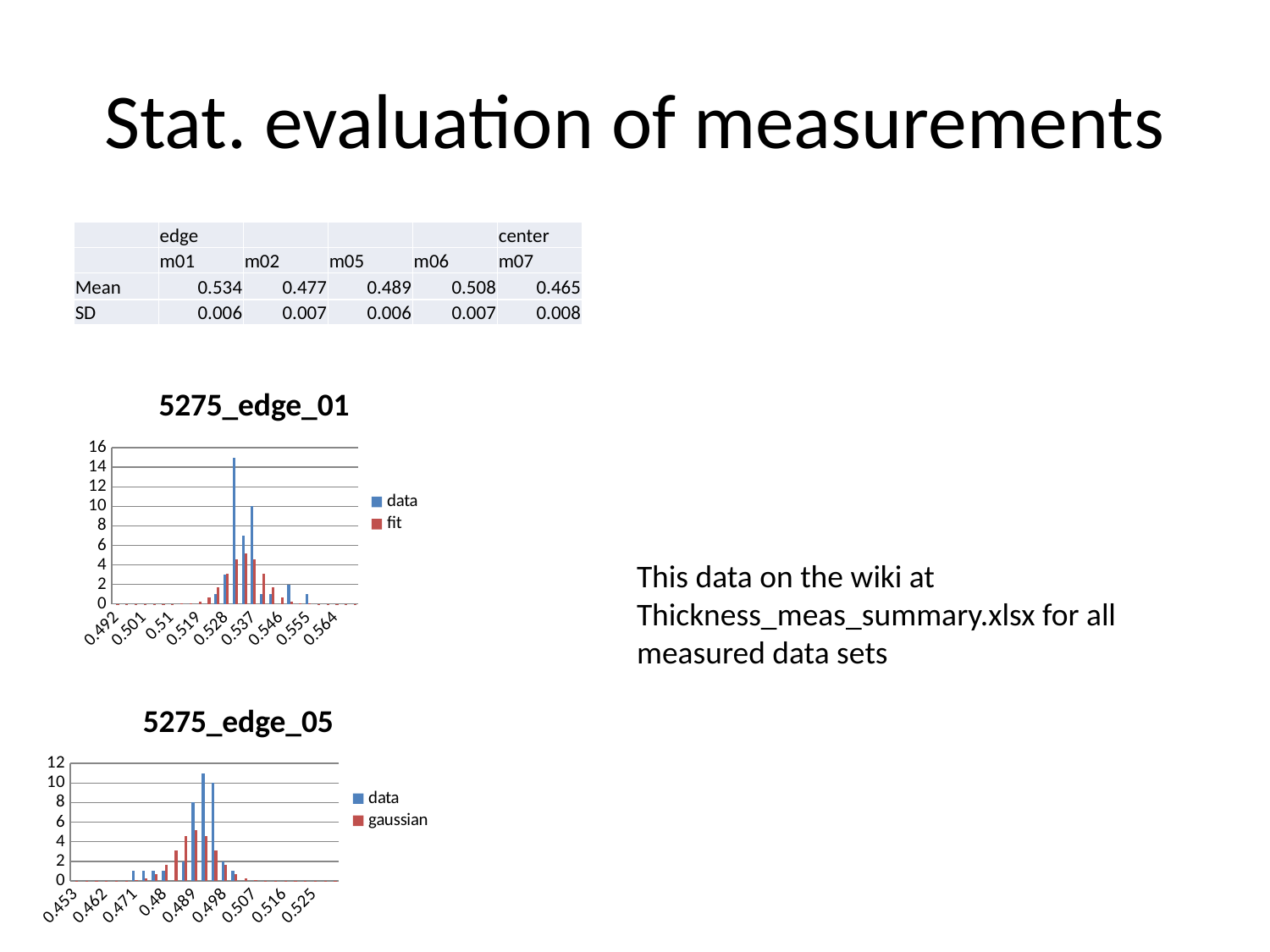
What are the two legend entries of the 5275_edge_01 chart? data and fit How many series does the legend of the 5275_edge_01 chart list? 2 What are the two legend entries of the 5275_edge_05 chart? data and gaussian In the 5275_edge_01 chart, which series has the taller peak bar, data or fit? data How many x-axis tick labels are shown on the 5275_edge_05 chart? 9 How many series does the legend of the 5275_edge_05 chart list? 2 What kind of chart is the 5275_edge_01 chart? bar chart What is the highest value shown on the y axis of the 5275_edge_01 chart? 16 What kind of chart is the 5275_edge_05 chart? bar chart In the 5275_edge_05 chart, is the tallest data bar greater or less than 8? greater In the 5275_edge_01 chart, is the tallest data bar greater or less than 12? greater In the 5275_edge_05 chart, which series has the taller peak bar, data or gaussian? data